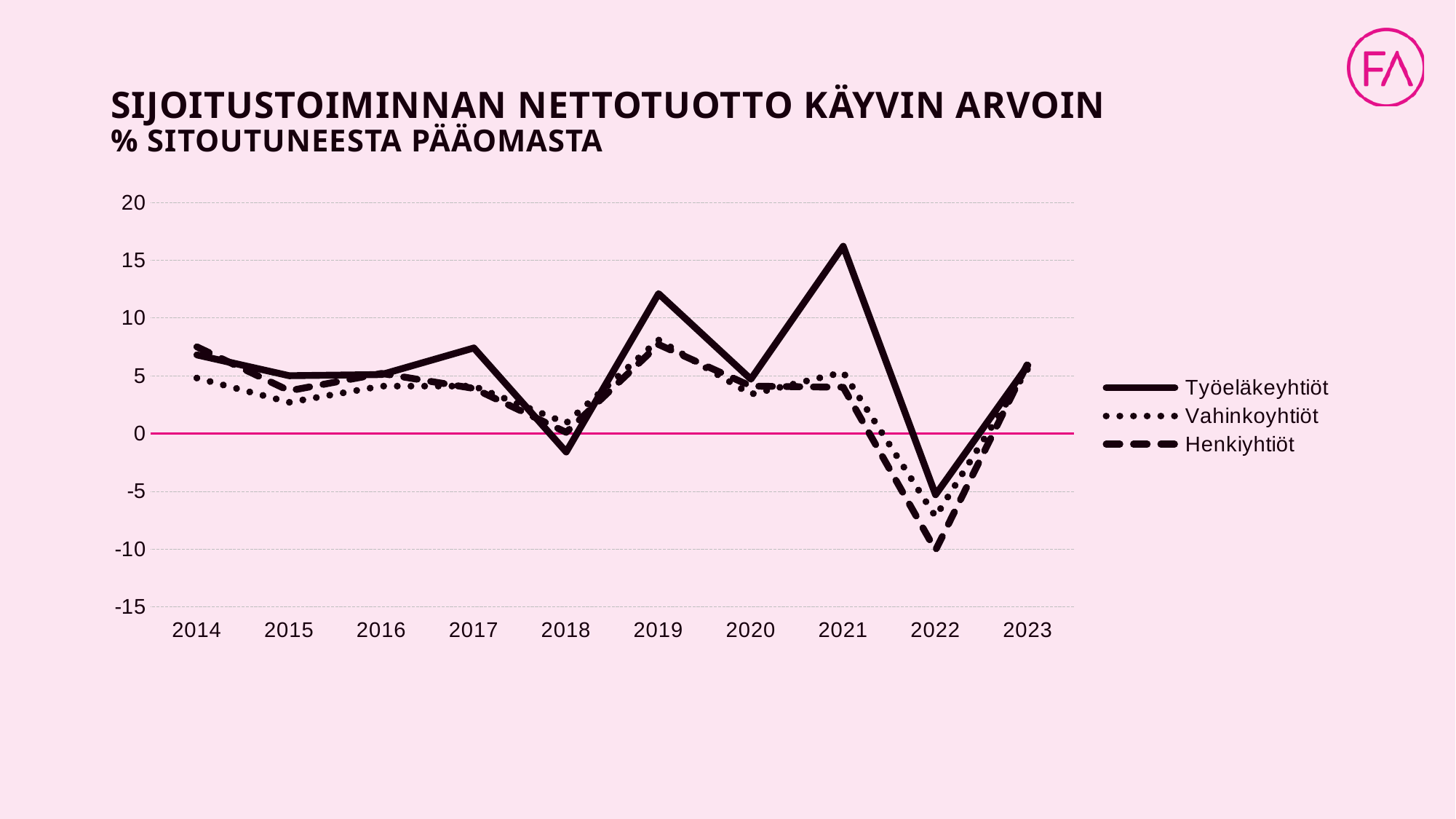
Is the value for Henkiyhtiöt in 2022 greater or less than -5? less Is the value for Työeläkeyhtiöt in 2019 greater or less than 10? greater Which line style represents Vahinkoyhtiöt in the legend? Dotted line In 2021, which series has the higher value: Työeläkeyhtiöt or Vahinkoyhtiöt? Työeläkeyhtiöt Is the value for Työeläkeyhtiöt in 2021 greater or less than 15? greater Does the Työeläkeyhtiöt line rise or fall from 2021 to 2022? Fall In which year does the Työeläkeyhtiöt line reach its highest value? 2021 How many series does the legend list? 3 How many years are shown on the x axis? 10 In which year does the Henkiyhtiöt line reach its lowest value? 2022 In 2022, which series has the higher value: Työeläkeyhtiöt or Henkiyhtiöt? Työeläkeyhtiöt What kind of chart is shown on the slide? Line chart